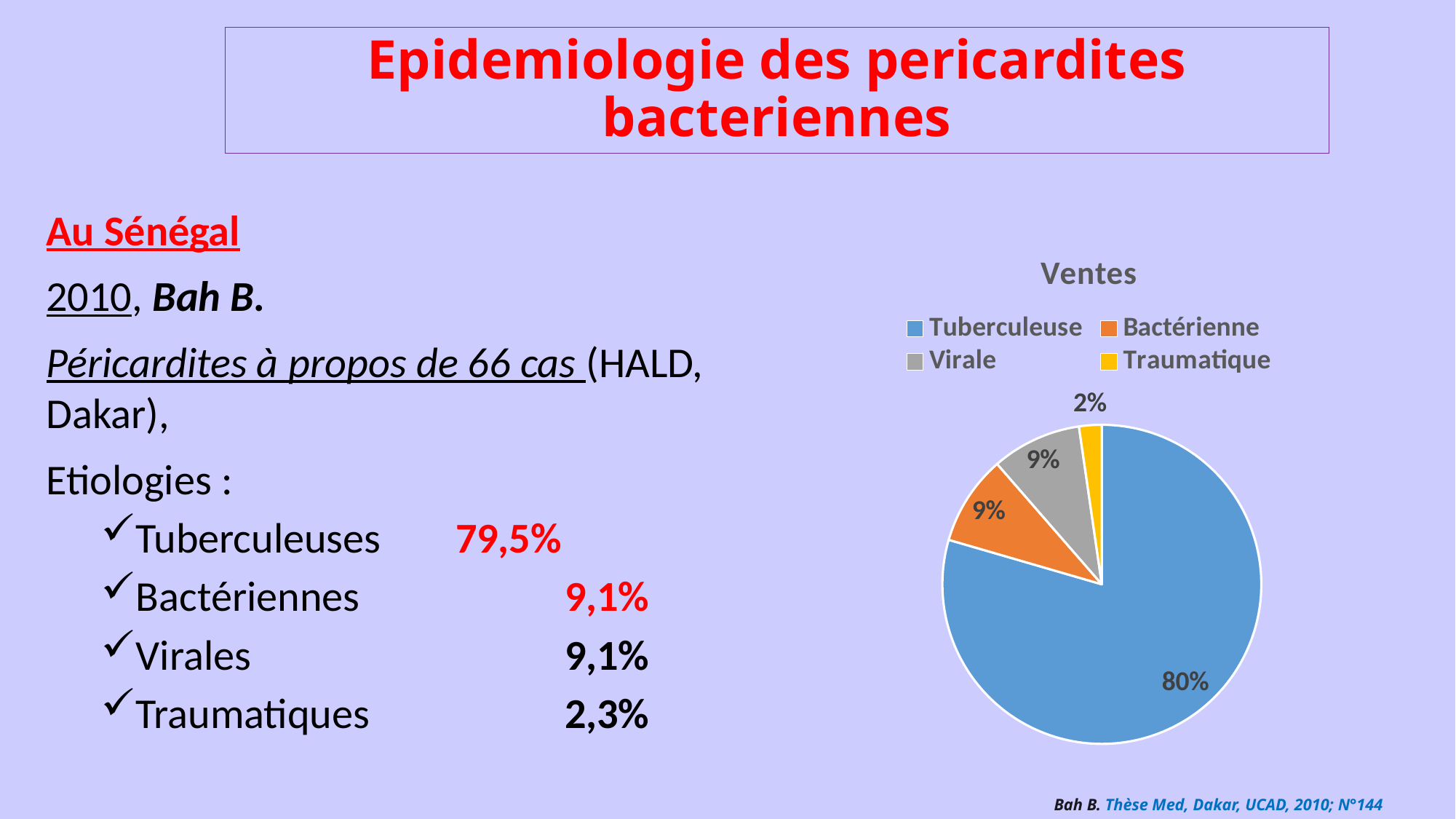
Which category has the largest slice of the pie? Tuberculeuse What is the difference in percentage points between the Tuberculeuse slice and the Traumatique slice? 78 What percentage is shown for the Bactérienne slice? 9% What colour is the Traumatique slice in the pie chart? yellow What type of chart is shown on the slide? pie chart Which category has the smallest slice of the pie? Traumatique What is the difference in percentage points between the Virale slice and the Traumatique slice? 7 What percentage is shown for the Traumatique slice? 2% How many slices does the pie chart have? 4 What is the title of the chart? Ventes Which slice is larger, Tuberculeuse or Virale? Tuberculeuse What percentage of the pie does the Tuberculeuse slice represent? 80%